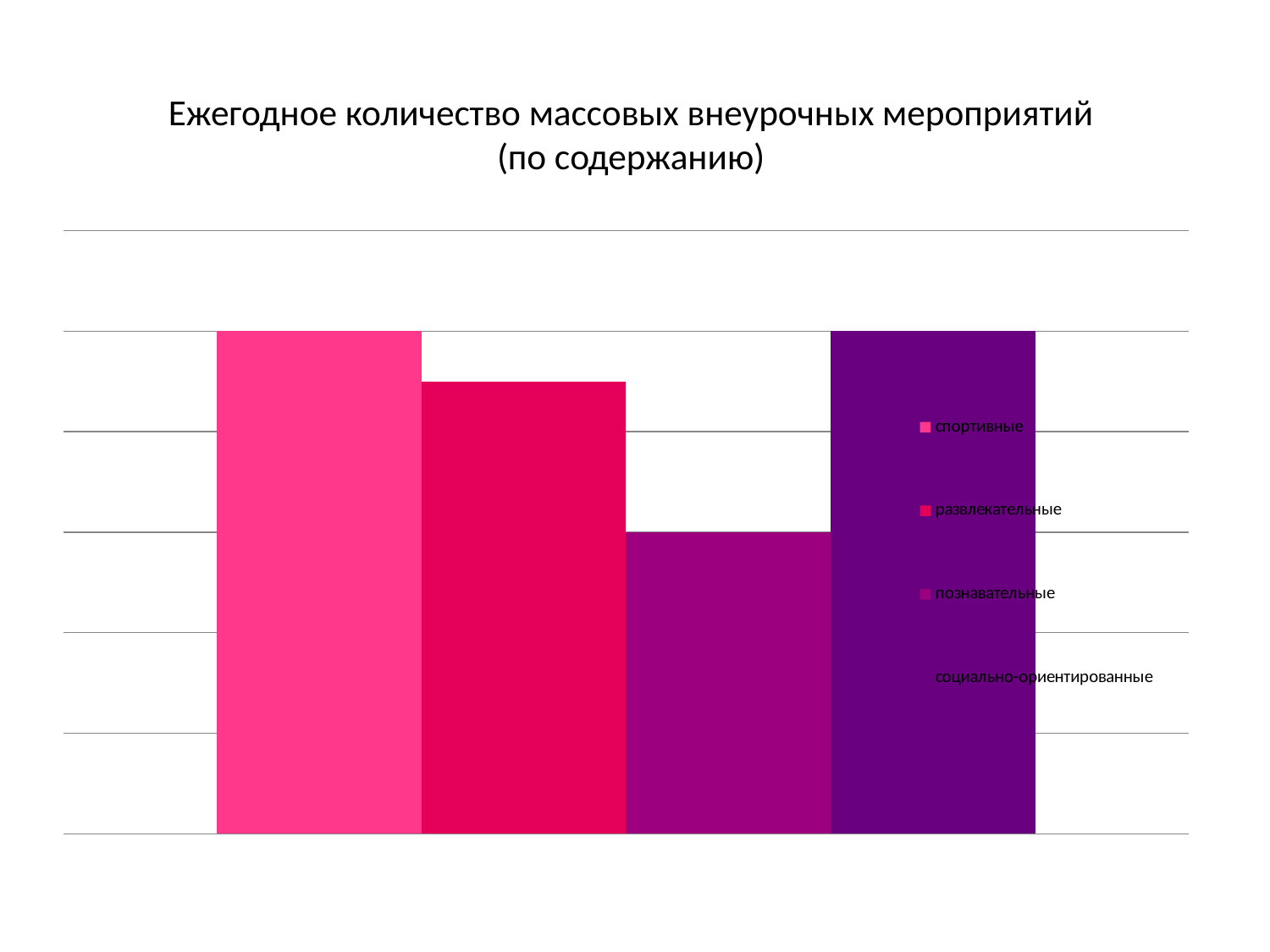
Which is larger, the value for спортивные or the value for развлекательные? спортивные Which legend entry is listed last? социально-ориентированные How many entries does the legend list? 4 How many bars are plotted in the chart? 4 Which category has the lowest bar? познавательные Which is larger, the value for развлекательные or the value for познавательные? развлекательные What kind of chart is shown on the slide? bar chart Which is larger, the value for социально-ориентированные or the value for познавательные? социально-ориентированные What is the title of the chart? Ежегодное количество массовых внеурочных мероприятий (по содержанию)